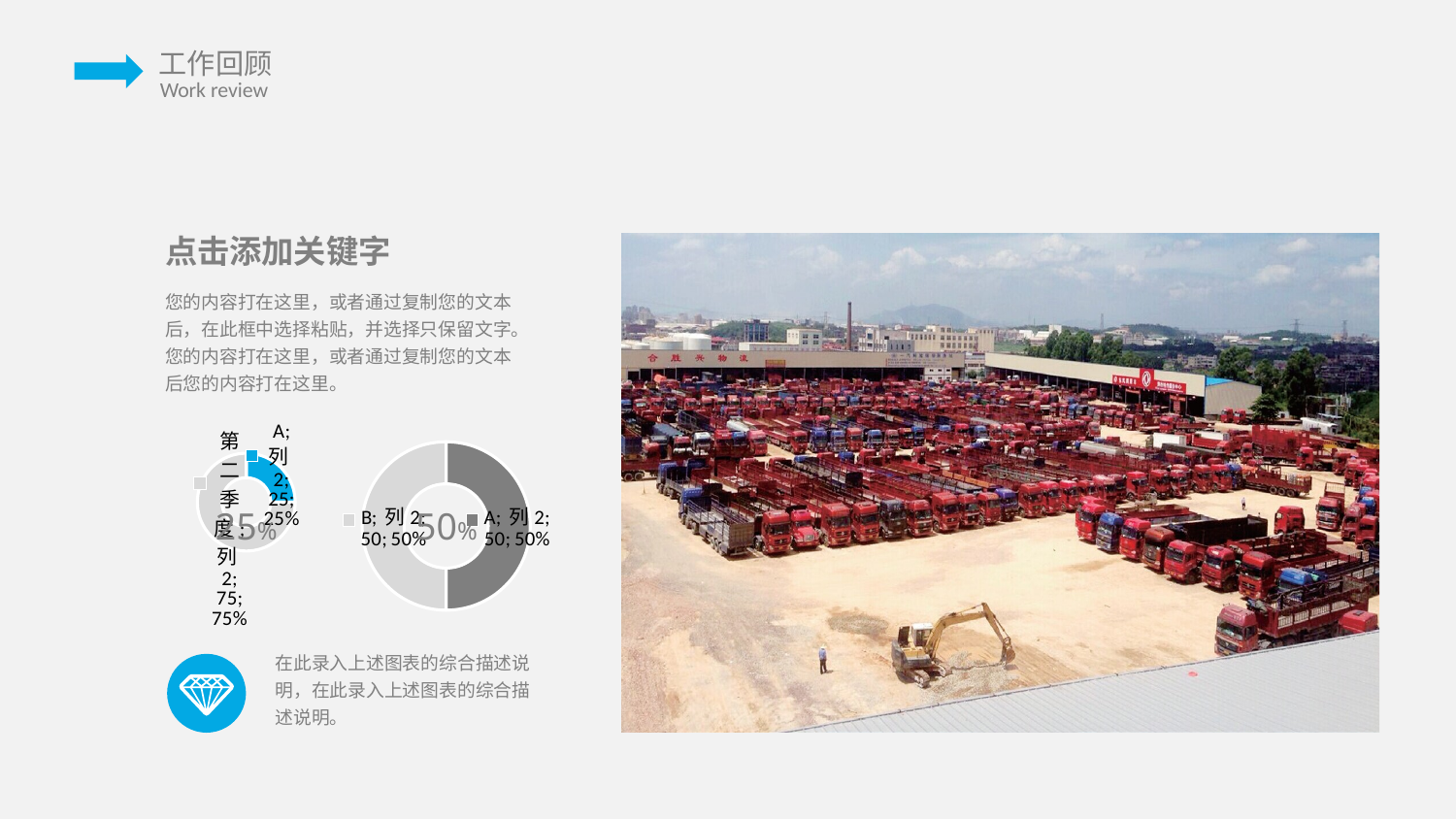
In the left doughnut chart, what is the value for category A? 25 In the right doughnut chart, what percentage share does category A have? 50% In the left doughnut chart, which category has the largest share? 第二季度 In the right doughnut chart, what is the value for category B? 50 In the left doughnut chart, what percentage is shown in the centre? 25% In the left doughnut chart, which category has the smallest share? A In the left doughnut chart, what percentage share does 第二季度 have? 75% In the left doughnut chart, what is the value for 第二季度? 75 In the left doughnut chart, what is the difference between the values for 第二季度 and A? 50 In the right doughnut chart, what percentage is shown in the centre? 50% In the right doughnut chart, how many categories are plotted? 2 What kind of chart is the right chart? doughnut chart